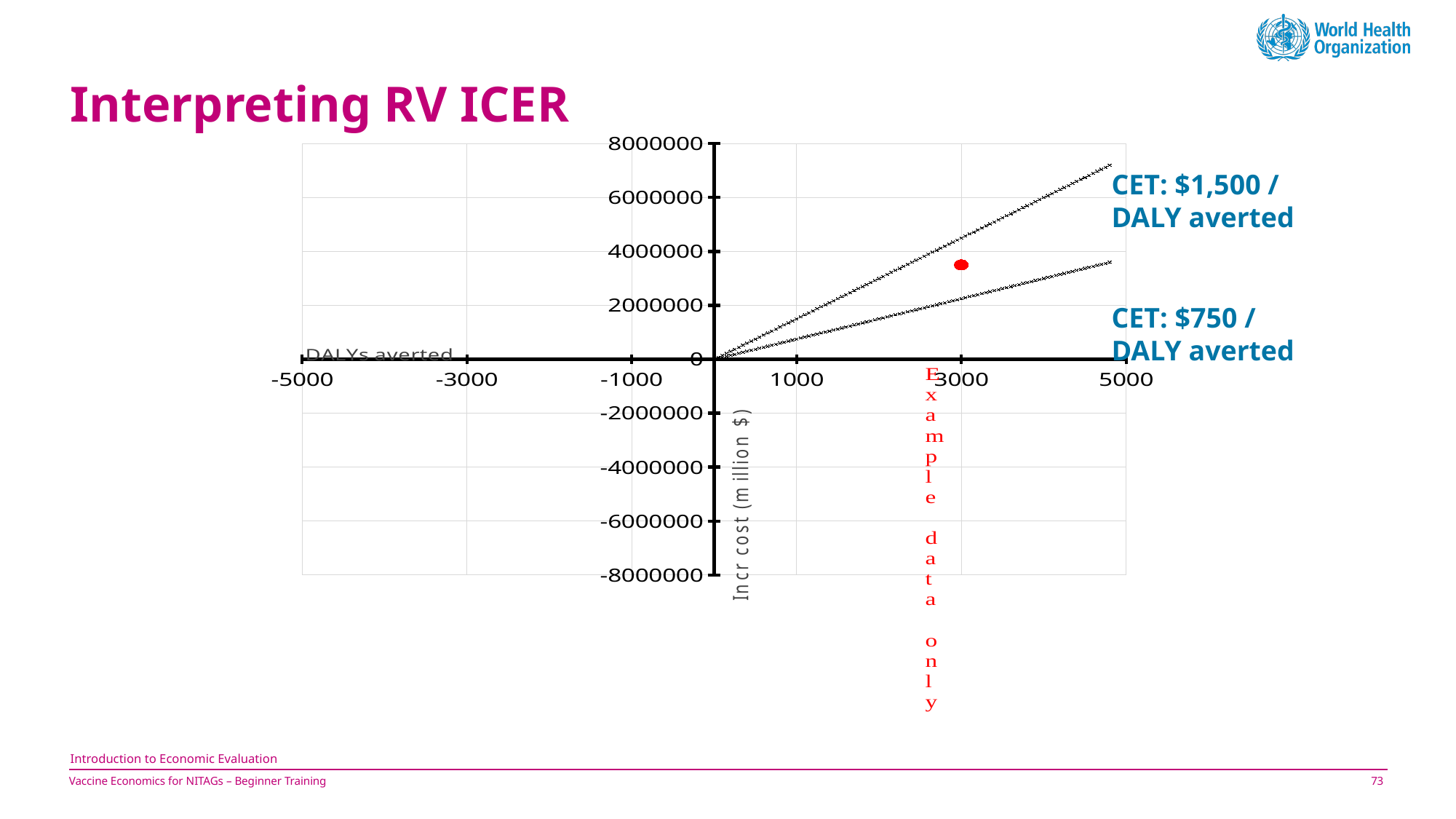
What is the minimum value shown on the horizontal axis of the chart? -5000 Is the DALYs averted value of the red data point greater or less than 5000? less Is the incremental cost of the red data point greater or less than 2000000? greater What is the maximum value shown on the vertical axis of the chart? 8000000 What is the label of the horizontal axis of the chart? DALYs averted What is the label of the vertical axis of the chart? Incr cost (million $) Which cost-effectiveness threshold line is steeper, CET $1,500 / DALY averted or CET $750 / DALY averted? CET: $1,500 / DALY averted How many red data points are plotted on the chart? 1 Is the DALYs averted value of the red data point greater or less than 1000? greater What kind of chart is shown on the slide? scatter chart Does the red data point lie above or below the CET $750 / DALY averted line? above